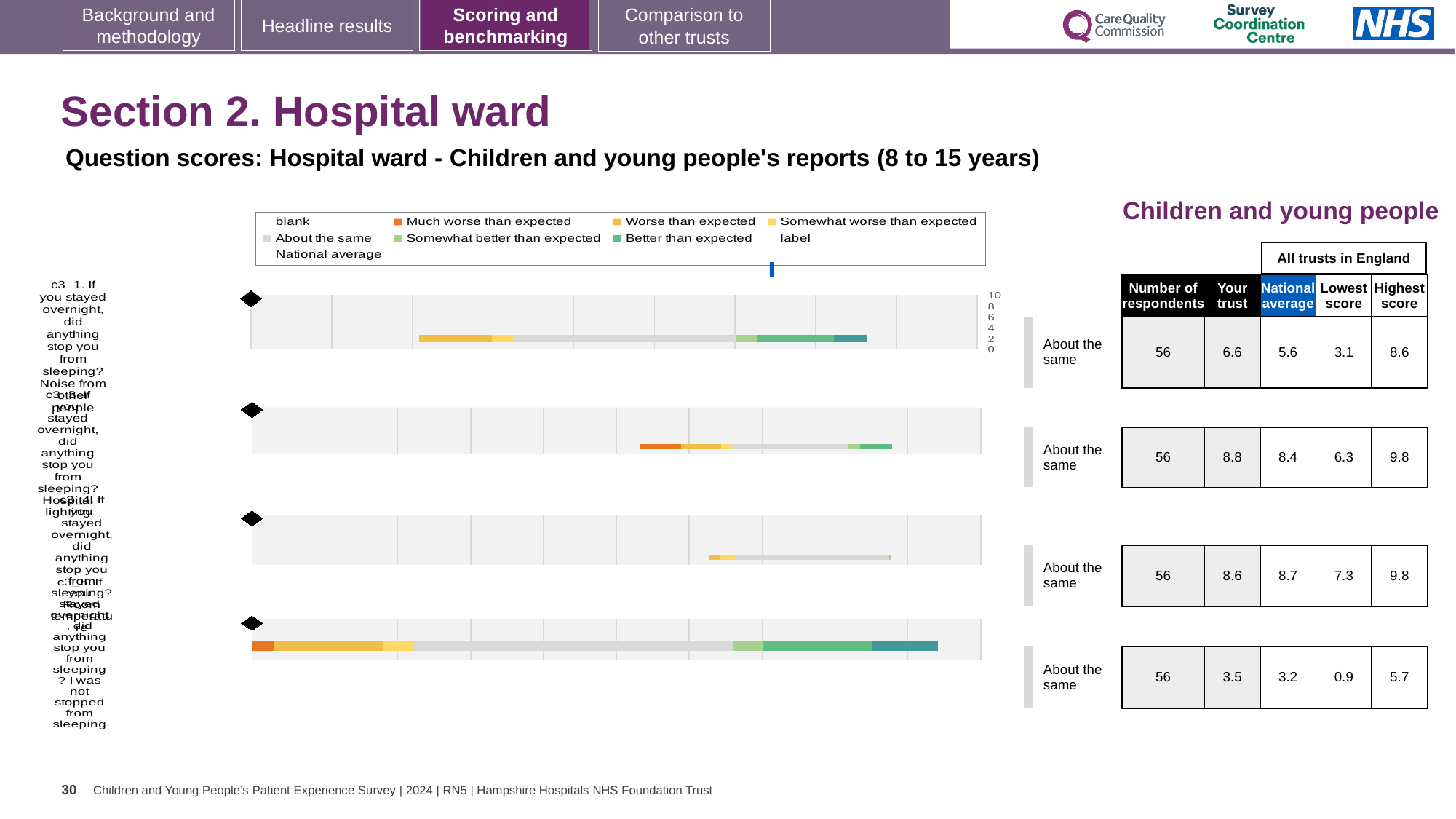
How many benchmark bar charts are shown on the slide? 4 Which of the four charts has the lowest 'Your trust' score in the table? the fourth chart (3.5) For the second chart from the top, which is larger: the 'Your trust' score or the national average? Your trust For the first chart (c3_1, noise from other people), what is the national average shown in the table? 5.6 Which of the four charts has the highest 'Your trust' score in the table? the second chart (8.8) What kind of chart is used for the four benchmark charts on the slide? bar chart In the chart legend, what does the light grey colour represent? About the same For the first chart (c3_1, noise from other people), what is the 'Your trust' score shown in the table? 6.6 For the first chart (c3_1, noise from other people), what is the highest score among all trusts in England? 8.6 In the chart legend, which colour represents 'Much worse than expected'? orange For the first chart (c3_1, noise from other people), how much higher is the 'Your trust' score than the national average? 1.0 How many respondents are listed for the fourth chart from the top? 56